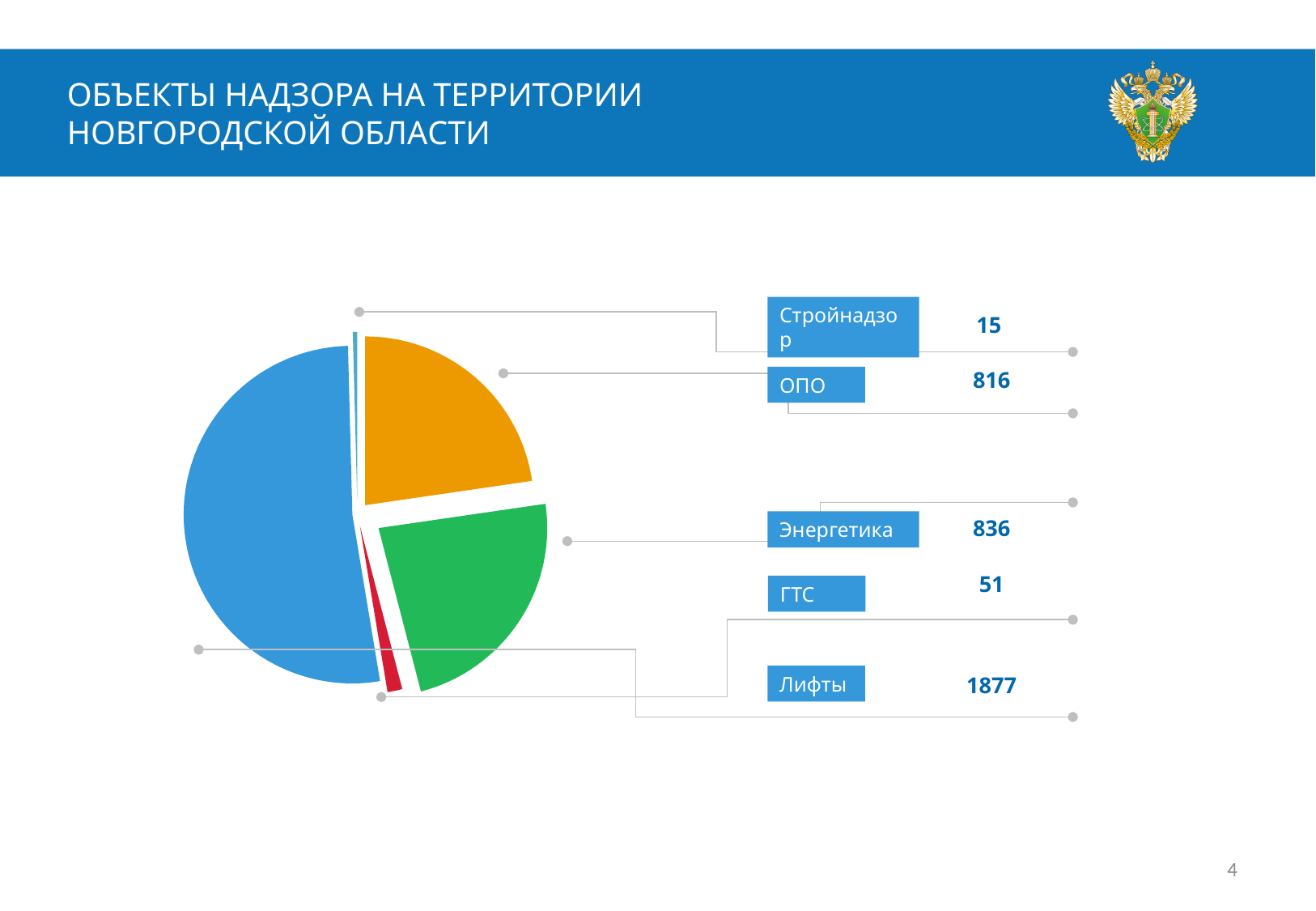
What is the value for ГТС? 51 What type of chart is shown on the slide? pie chart Which category has the highest value? Лифты How many categories does the pie chart show? 5 What is the value for Лифты? 1877 What is the difference between the values for Энергетика and ОПО? 20 What colour is the slice for Лифты? blue What is the value for ОПО? 816 Which is larger, the value for ГТС or the value for Стройнадзор? ГТС What is the total of all the values shown in the pie chart? 3595 Which category has the lowest value? Стройнадзор What is the value for Энергетика? 836